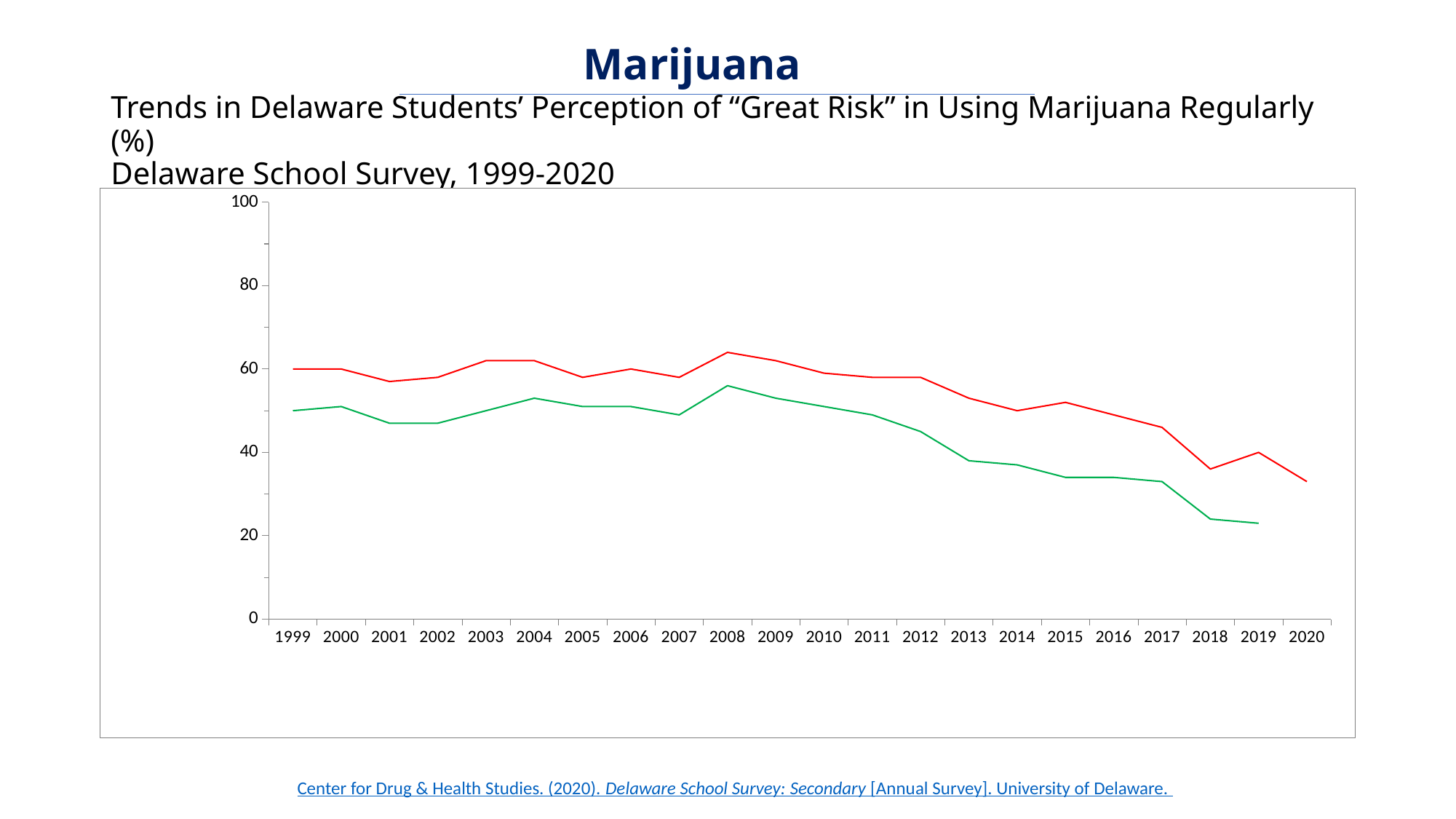
What is the first year shown on the x axis? 1999 What is the last year shown on the x axis? 2020 In 2010, which line has the higher value, the red line or the green line? the red line In which year does the green line reach its highest value? 2008 In which year does the red line reach its highest value? 2008 In which year does the red line reach its lowest value? 2020 How many years are shown along the x axis of the chart? 22 What kind of chart is shown on the slide? line chart Is the value of the green line in 2019 greater or less than 40? less Is the value of the red line in 2008 greater or less than 60? greater Overall, do the values of the red line rise or fall from 1999 to 2020? fall Overall, do the values of the green line rise or fall from 1999 to 2019? fall